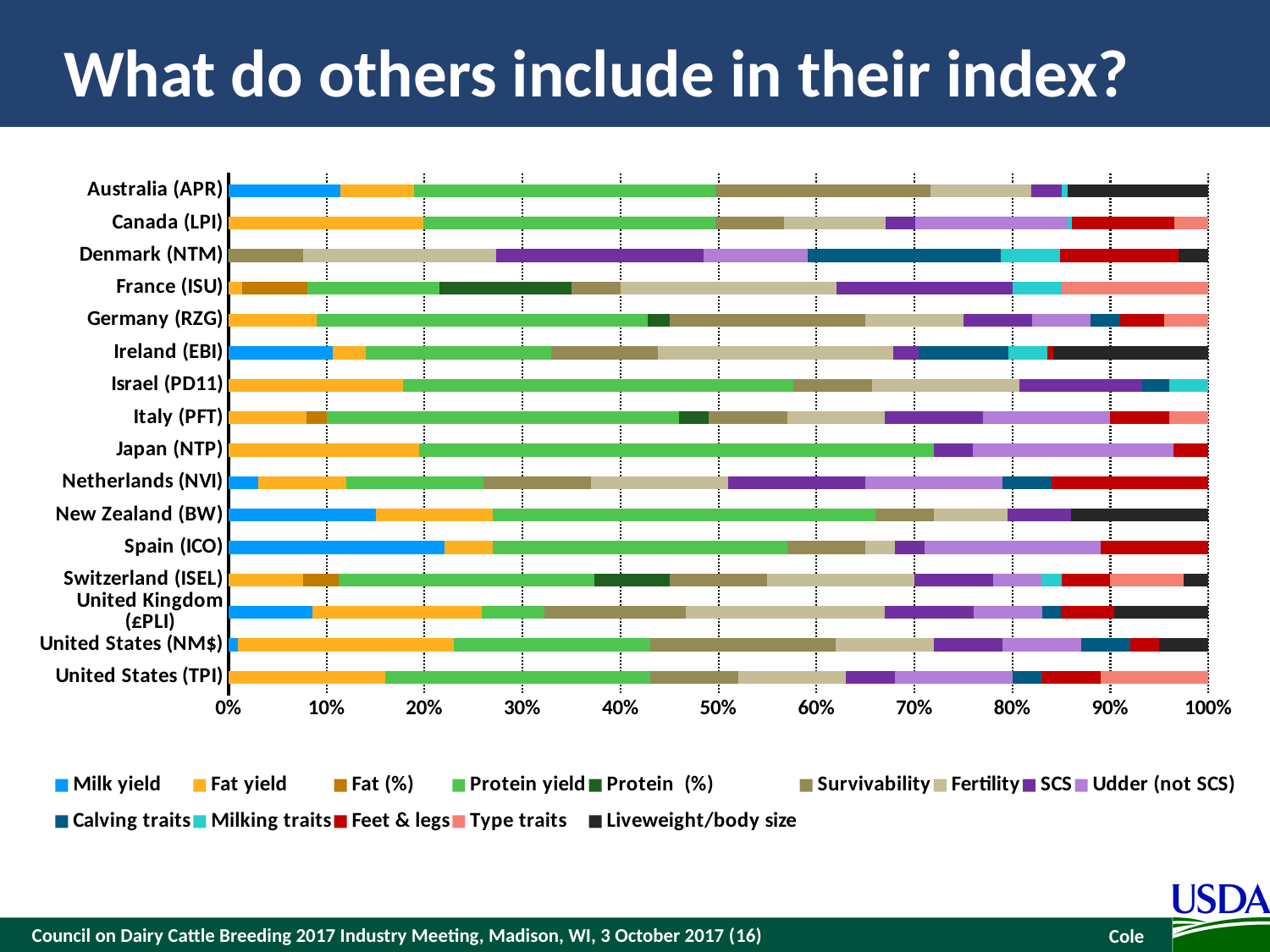
How many series does the chart's legend list? 14 Is the Protein yield value for Japan (NTP) greater or less than 50%? greater Which has the larger Milk yield share, Spain (ICO) or New Zealand (BW)? Spain (ICO) Which series is listed first in the chart's legend? Milk yield Which index has the largest Milk yield share? Spain (ICO) How many countries/indices are listed on the vertical axis of the chart? 16 Which index has the largest Protein yield share? Japan (NTP) What kind of chart is shown on the slide? Stacked bar chart Is the Milk yield value for New Zealand (BW) greater or less than 10%? greater Is the Milk yield value for Spain (ICO) greater or less than 20%? greater What is the title of the slide containing the chart? What do others include in their index? What does each stacked bar in the chart total? 100%